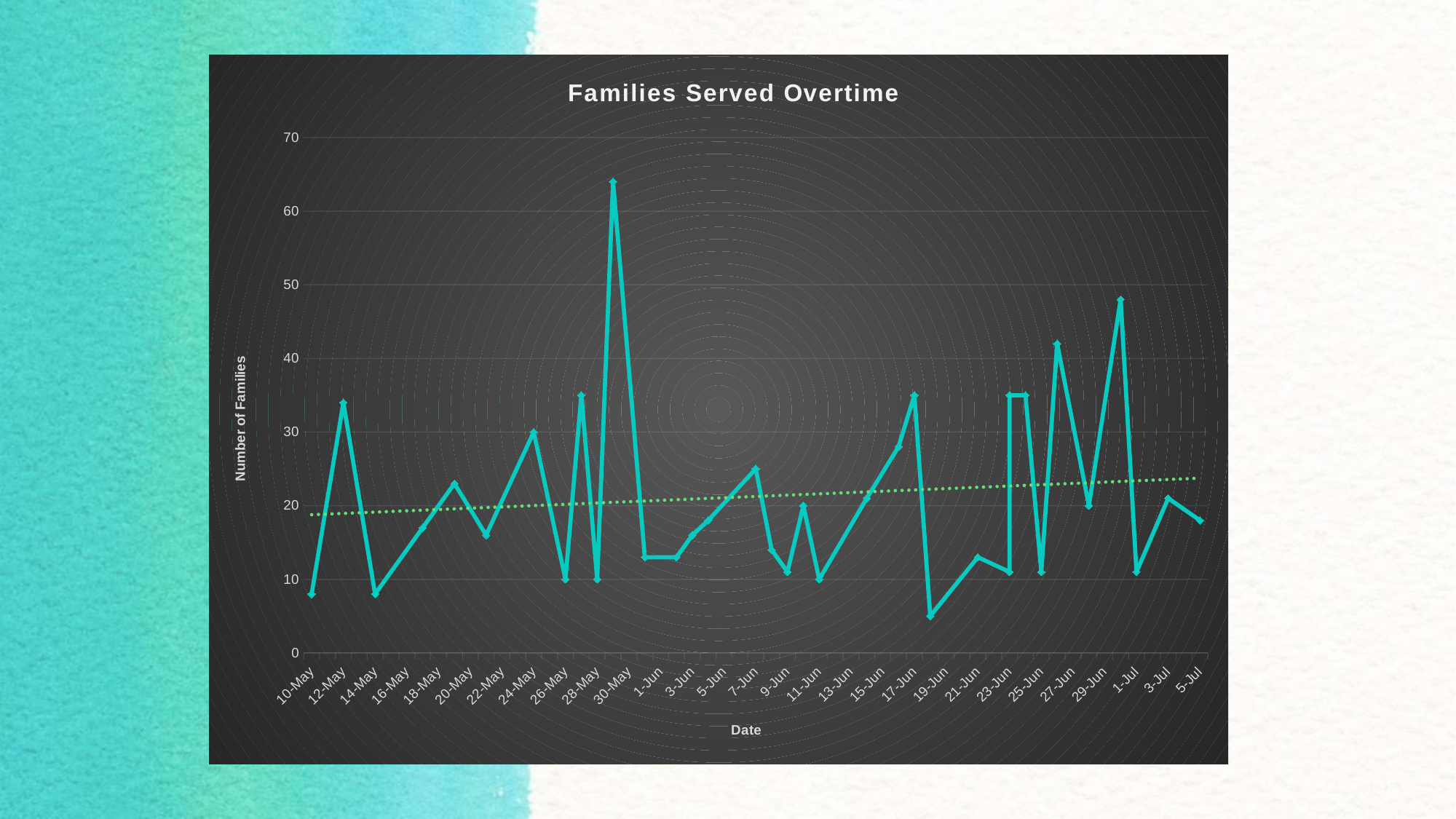
Which has the larger value, 12-May or 14-May? 12-May Is the value for 10-May greater or less than 10? less Is the value for 1-Jul greater or less than 20? less What kind of chart is shown on the slide? line chart Is the highest value on the chart greater or less than 60? greater What is the label on the vertical axis of the chart? Number of Families What is the title of the chart? Families Served Overtime Does the dotted trend line rise or fall from left to right? rise Which has the larger value, 10-May or 12-May? 12-May